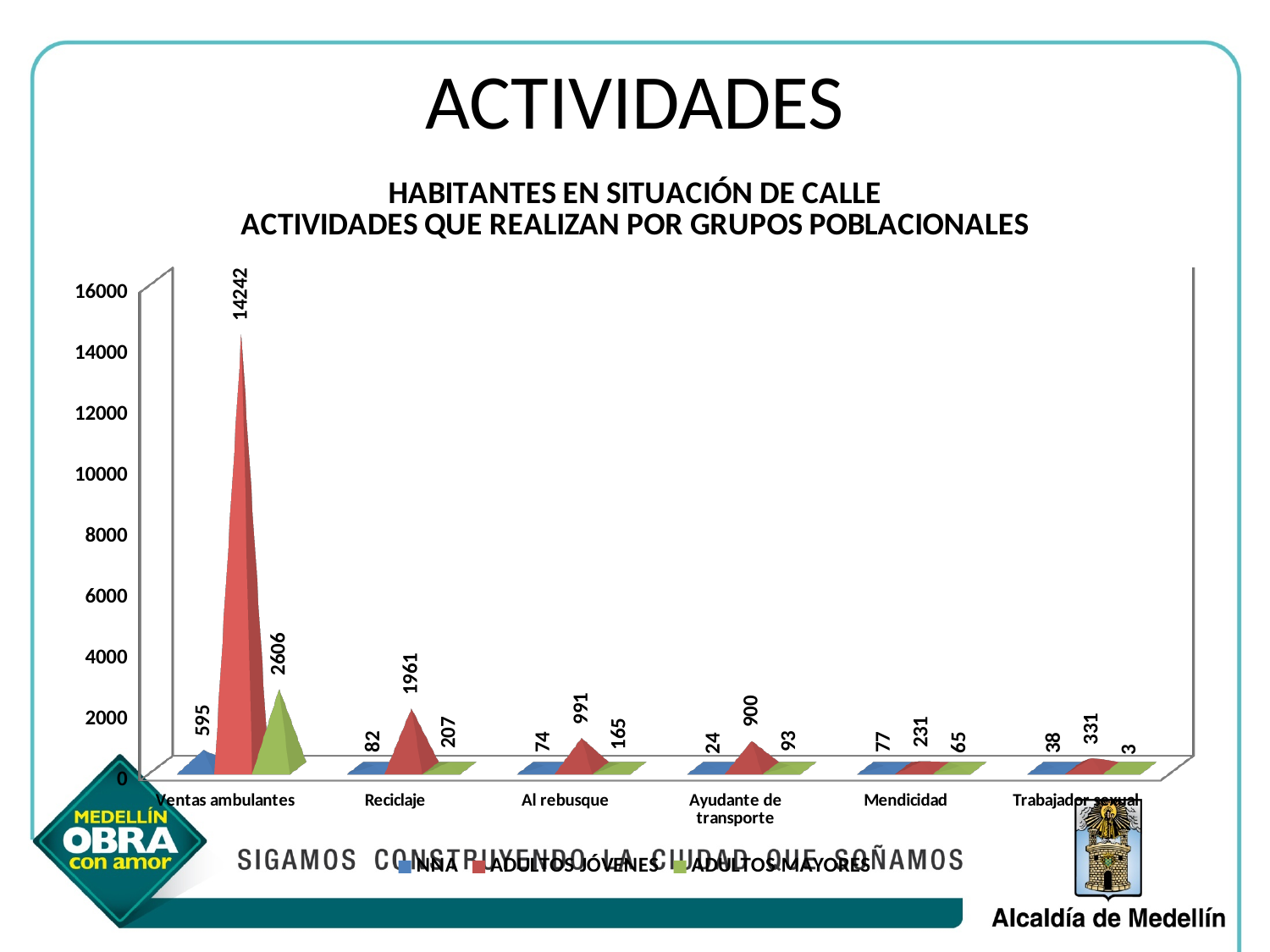
What is the total of the three series values in the Reciclaje category? 2250 How many activity categories are shown on the x axis? 6 What is the value for ADULTOS JÓVENES in the Ventas ambulantes category? 14242 What is the value for NNA in the Ayudante de transporte category? 24 What is the value for ADULTOS MAYORES in the Reciclaje category? 207 Which is larger in the Al rebusque category: the NNA value or the ADULTOS MAYORES value? ADULTOS MAYORES Which category has the lowest value for ADULTOS MAYORES? Trabajador sexual What is the value for ADULTOS JÓVENES in the Mendicidad category? 231 How many series does the legend list? 3 What is the difference between the ADULTOS JÓVENES value and the ADULTOS MAYORES value in the Ventas ambulantes category? 11636 Which category has the highest value for ADULTOS JÓVENES? Ventas ambulantes What kind of chart is shown on the slide? Bar chart